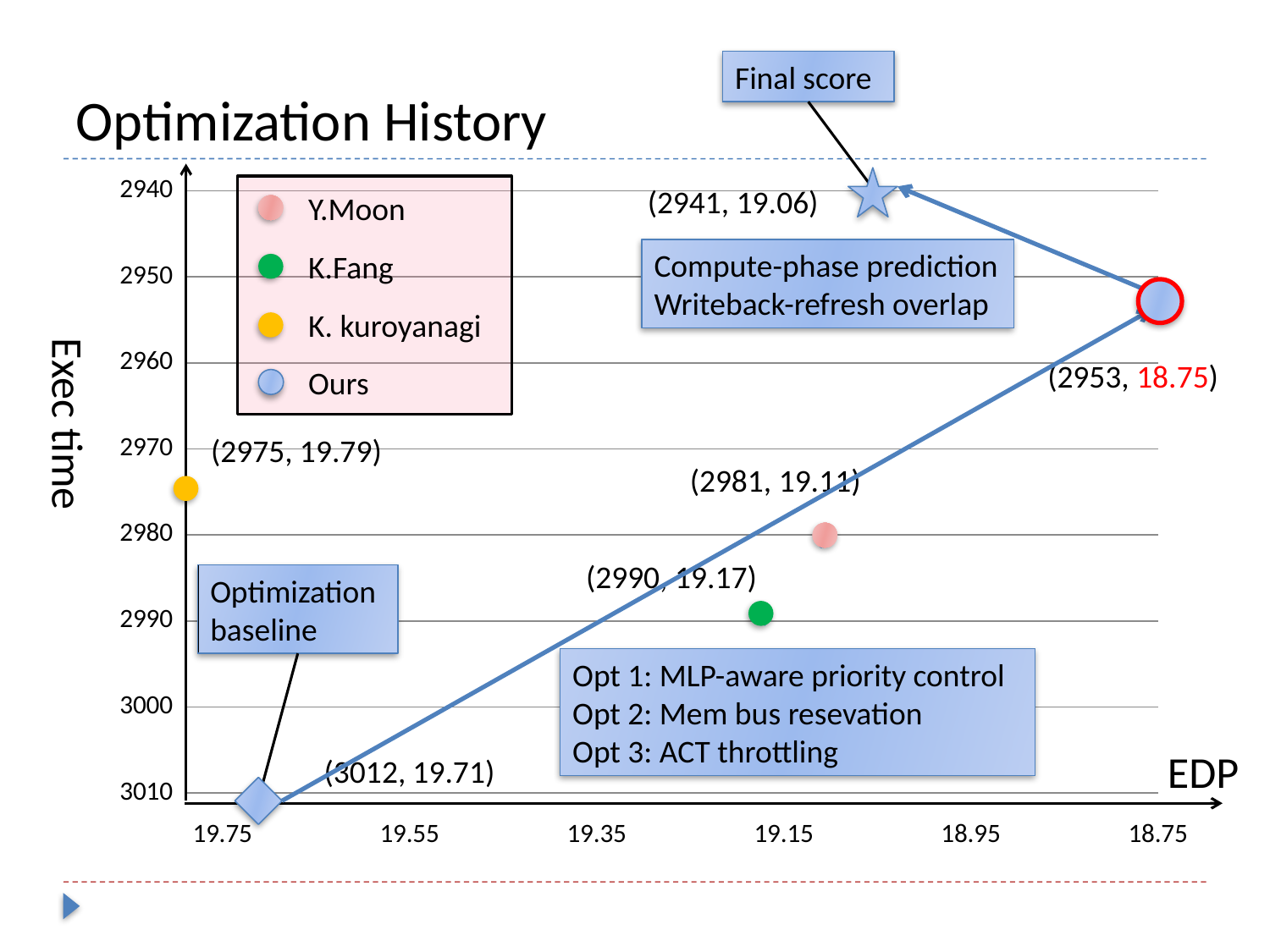
What is the title of the chart? Optimization History What is the EDP of the 'Ours' point circled in red? 18.75 What is the EDP value of the K. kuroyanagi point? 19.79 What are the coordinates (exec time, EDP) of the point labelled 'Final score'? (2941, 19.06) What kind of chart is shown on the slide? scatter chart What are the coordinates (exec time, EDP) of the point labelled 'Optimization baseline'? (3012, 19.71) Which has the larger exec time, the Y.Moon point or the K.Fang point? K.Fang What is the difference in exec time between the Optimization baseline (3012) and the Final score (2941)? 71 Which labelled point has the lowest EDP? (2953, 18.75) How many entries does the legend list? 4 Which labelled point has the highest exec time? (3012, 19.71) What is the exec time of the K.Fang point? 2990